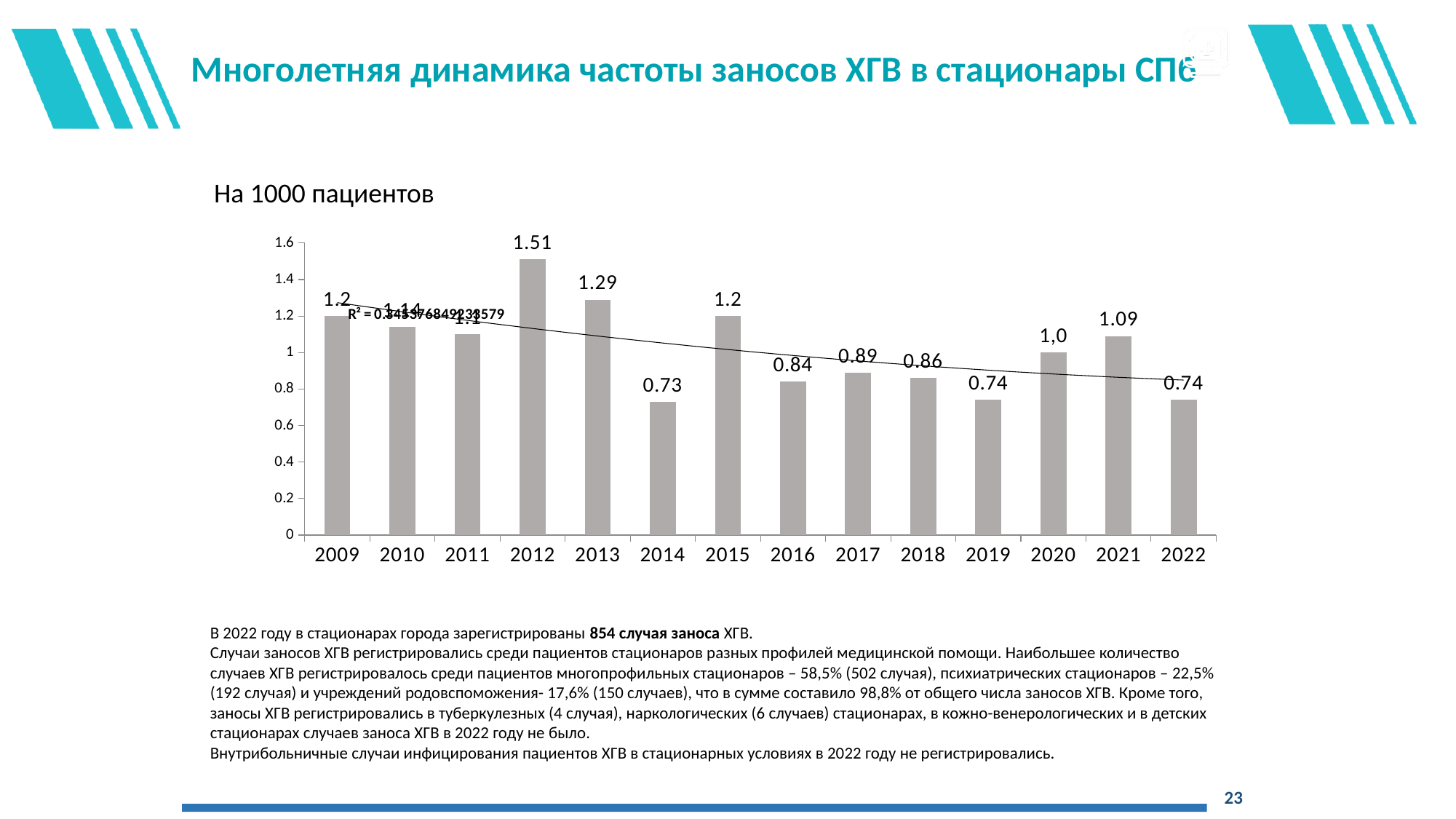
What kind of chart is this? bar chart What is the value for 2014? 0.73 What is the difference between the values for 2009 and 2022? 0.46 Which year has the lowest value? 2014 What is the value for 2017? 0.89 Do the values generally rise or fall from 2009 to 2022? fall What is the value for 2012? 1.51 How many years are shown on the x axis? 14 What is the difference between the values for 2012 and 2013? 0.22 Which is larger, the value for 2016 or the value for 2018? 2018 What is the value for 2021? 1.09 Which year has the highest value? 2012